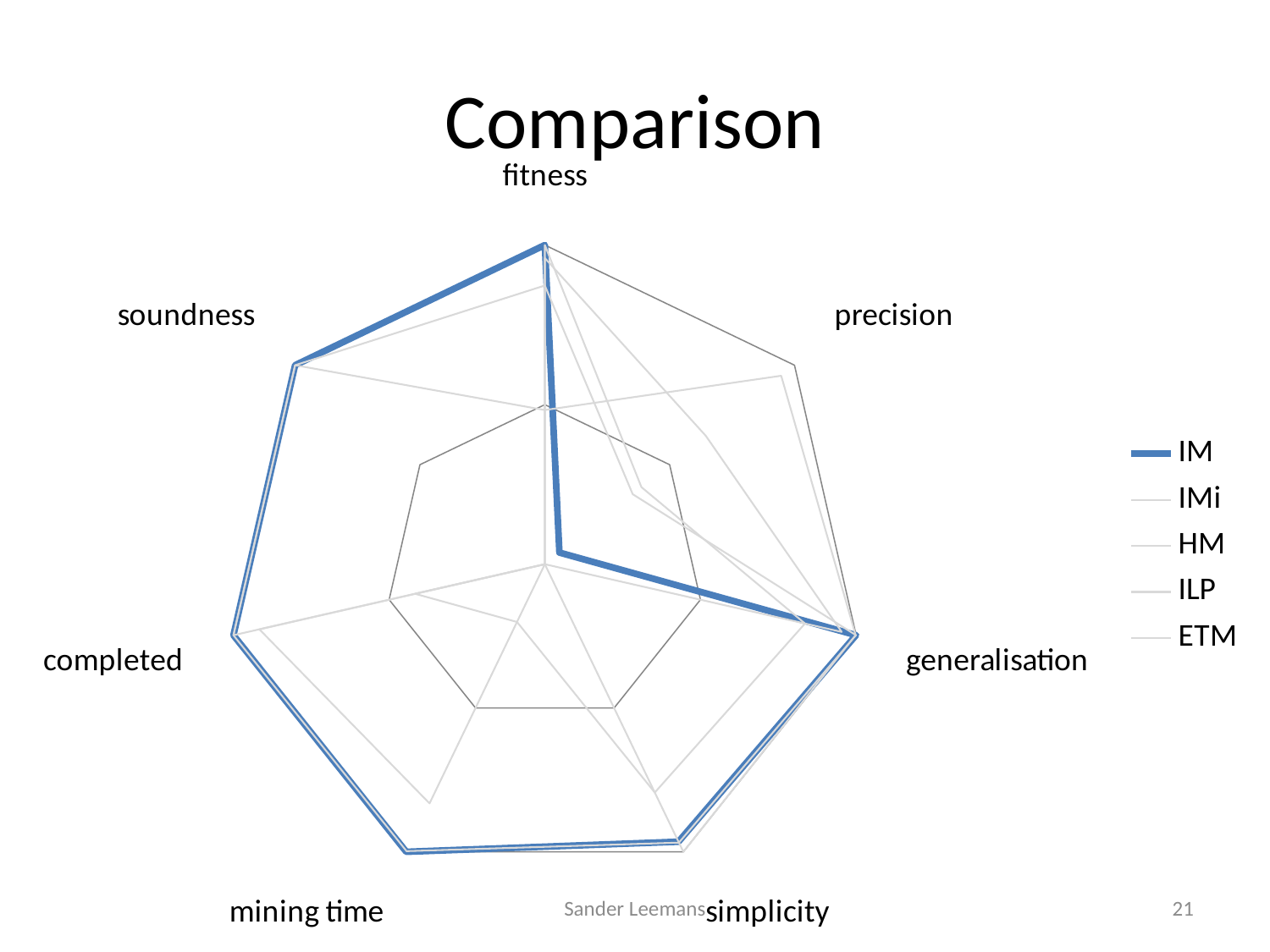
What kind of chart is shown on the slide? radar chart Which series is listed first in the legend? IM How many series does the legend list? 5 What is the title of the chart? Comparison On which axis does the IM series have its lowest value? precision How many axes (categories) does the radar chart have? 7 Which axis label appears at the top of the radar chart? fitness